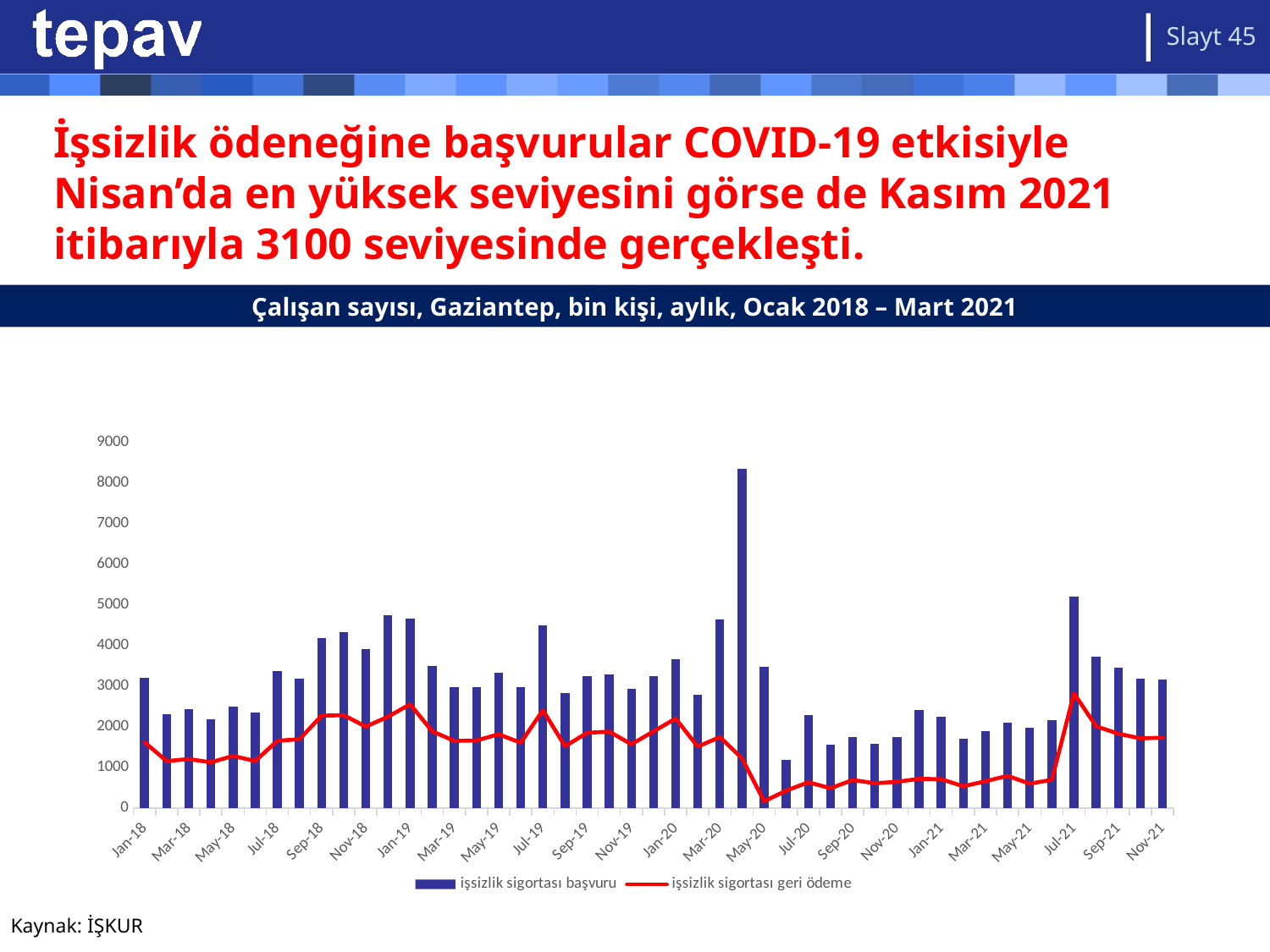
Which month has the larger işsizlik sigortası başvuru bar, Apr-20 or Jul-21? Apr-20 How many series does the legend list? 2 Is the işsizlik sigortası başvuru value for Jun-20 greater or less than 2000? less Do the işsizlik sigortası başvuru bars rise or fall from Apr-20 to Jun-20? fall What kind of chart is shown on the slide? bar chart with a line Which series is drawn as a red line? işsizlik sigortası geri ödeme What is the source given below the chart? İŞKUR How many monthly bars are plotted from Jan-18 to Nov-21? 47 In which month is the işsizlik sigortası başvuru bar highest? Apr-20 Is the işsizlik sigortası başvuru value for Apr-20 greater or less than 8000? greater Is the işsizlik sigortası geri ödeme value for Jul-21 greater or less than 2000? greater